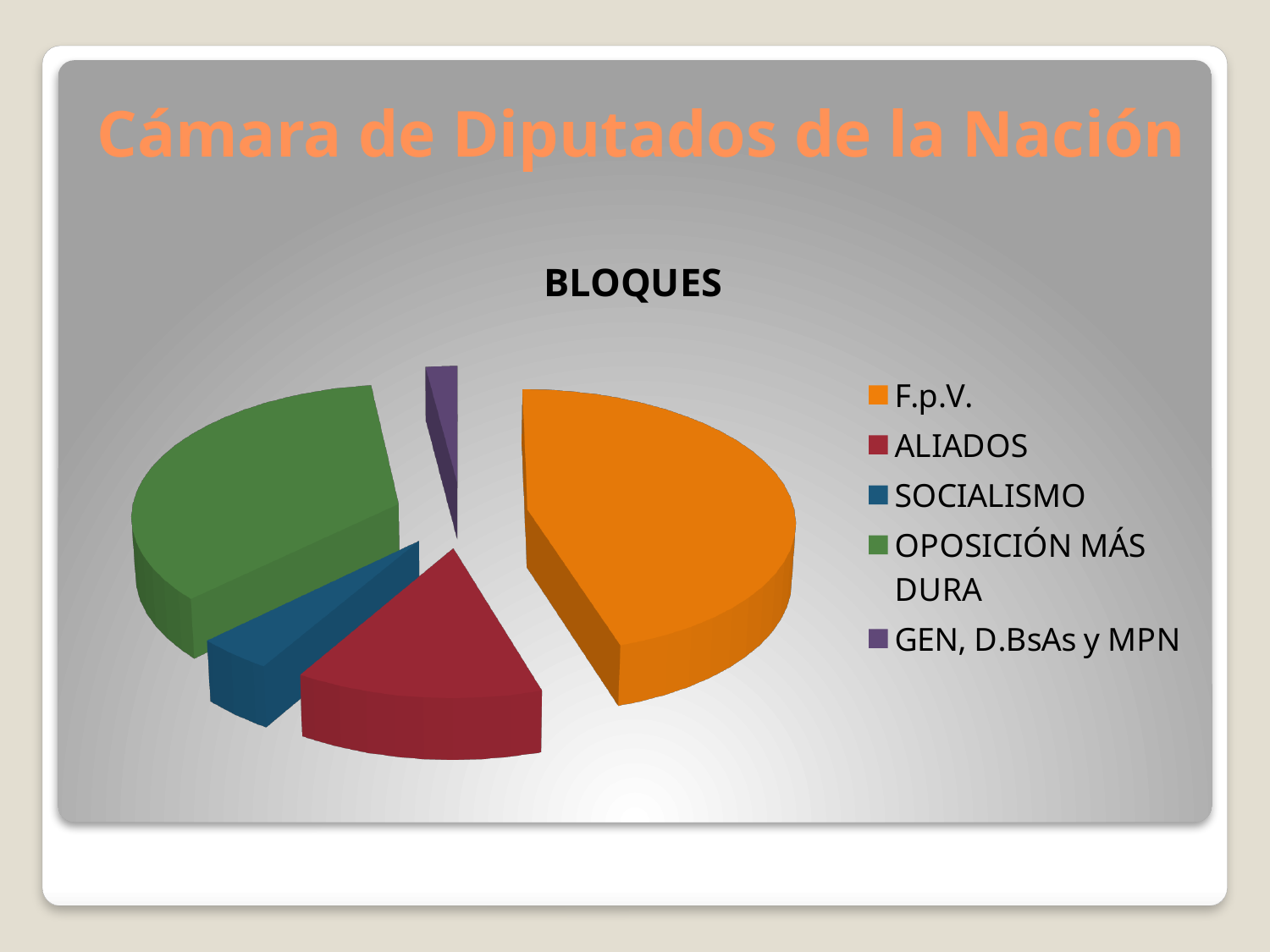
What colour is the slice for SOCIALISMO? blue How many slices does the pie chart have? 5 Which bloque has the largest slice of the pie? F.p.V. How many entries does the legend list? 5 What is the title of the chart? BLOQUES Which slice is larger, F.p.V. or ALIADOS? F.p.V. Which slice is larger, OPOSICIÓN MÁS DURA or ALIADOS? OPOSICIÓN MÁS DURA Which bloque has the smallest slice of the pie? GEN, D.BsAs y MPN Which slice is larger, OPOSICIÓN MÁS DURA or SOCIALISMO? OPOSICIÓN MÁS DURA What kind of chart is shown on the slide? pie chart